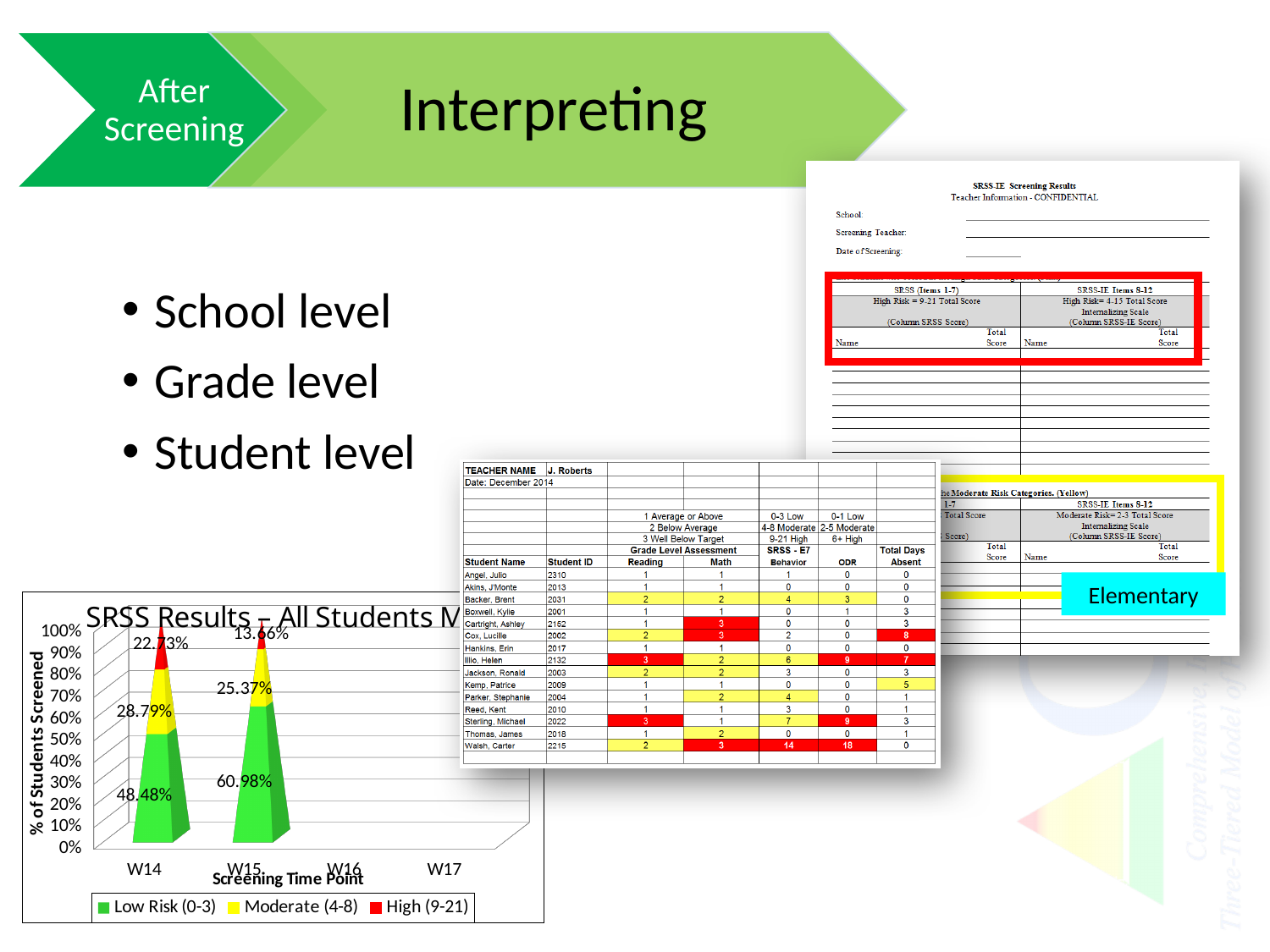
In the SRSS Results chart, by how many percentage points did the High (9-21) share fall from W14 to W15? 9.07 In the SRSS Results chart, what is the Moderate (4-8) value at W15? 25.37% What kind of chart is the SRSS Results chart? Stacked bar chart In the SRSS Results chart, which time point has the larger Low Risk (0-3) percentage, W14 or W15? W15 What is the y-axis title of the SRSS Results chart? % of Students Screened In the SRSS Results chart, what is the Moderate (4-8) value at W14? 28.79% In the SRSS Results chart, what percentage of students screened were High (9-21) at W15? 13.66% In the SRSS Results chart, what is the Low Risk (0-3) value at W15? 60.98% In the SRSS Results chart, what is the High (9-21) value at W14? 22.73% In the SRSS Results chart, what percentage of students screened were Low Risk (0-3) at W14? 48.48% How many series does the legend of the SRSS Results chart list? 3 In the SRSS Results chart, does the Low Risk (0-3) percentage rise or fall from W14 to W15? Rise